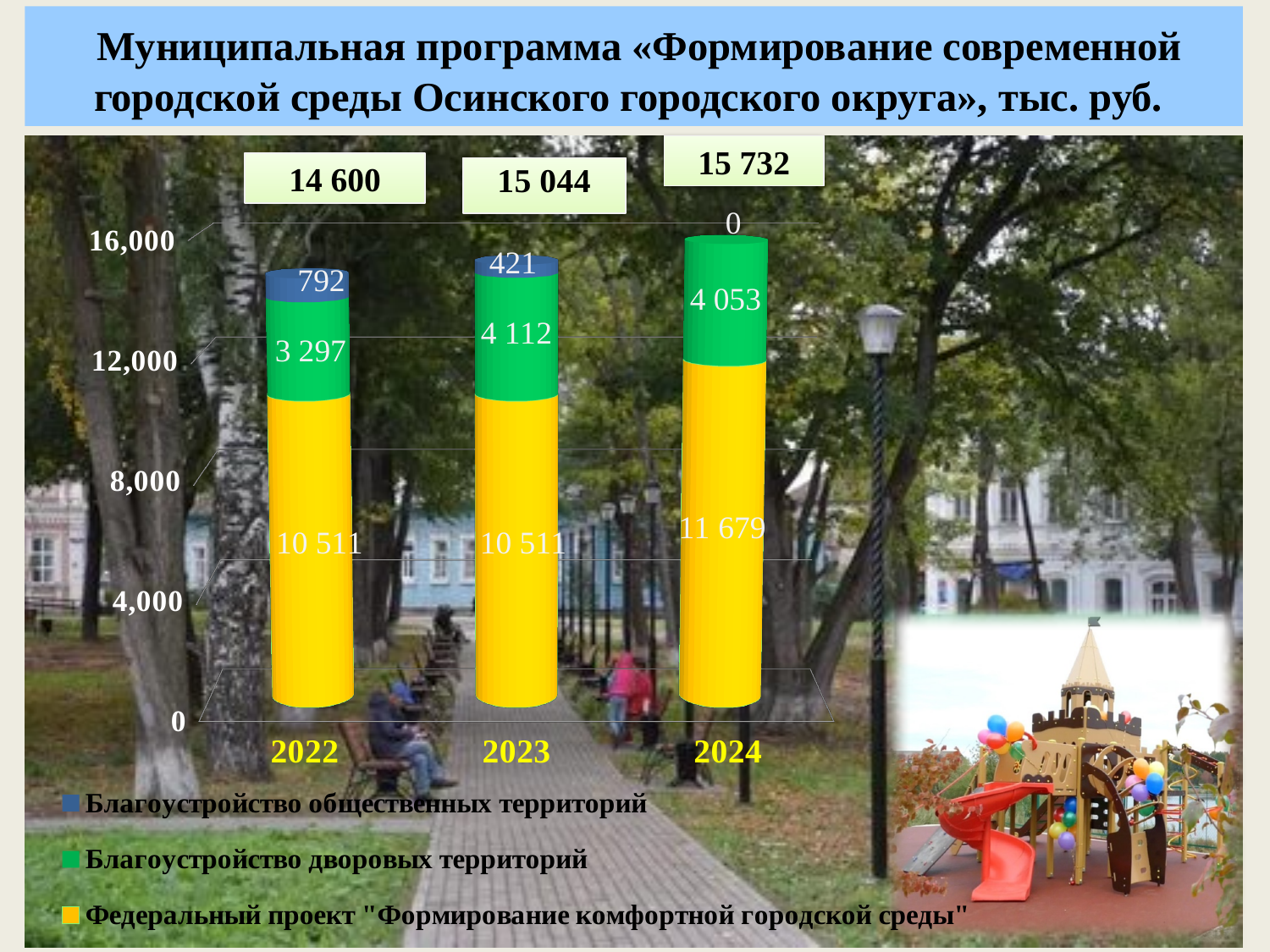
What type of chart is shown on the slide? stacked bar chart What is the total shown above the bar for 2024? 15 732 What is the value for «Федеральный проект "Формирование комфортной городской среды"» in 2024? 11 679 What is the difference between the totals for 2023 and 2022? 444 Which is larger: «Благоустройство дворовых территорий» in 2023 or in 2024? 2023 Which year has the lowest total? 2022 What is the value for «Благоустройство общественных территорий» in 2022? 792 How many series does the legend list? 3 How many years (categories) are shown on the x axis? 3 Do the totals rise or fall from 2022 to 2024? rise Which year has the highest total? 2024 What is the value for «Благоустройство дворовых территорий» in 2023? 4 112